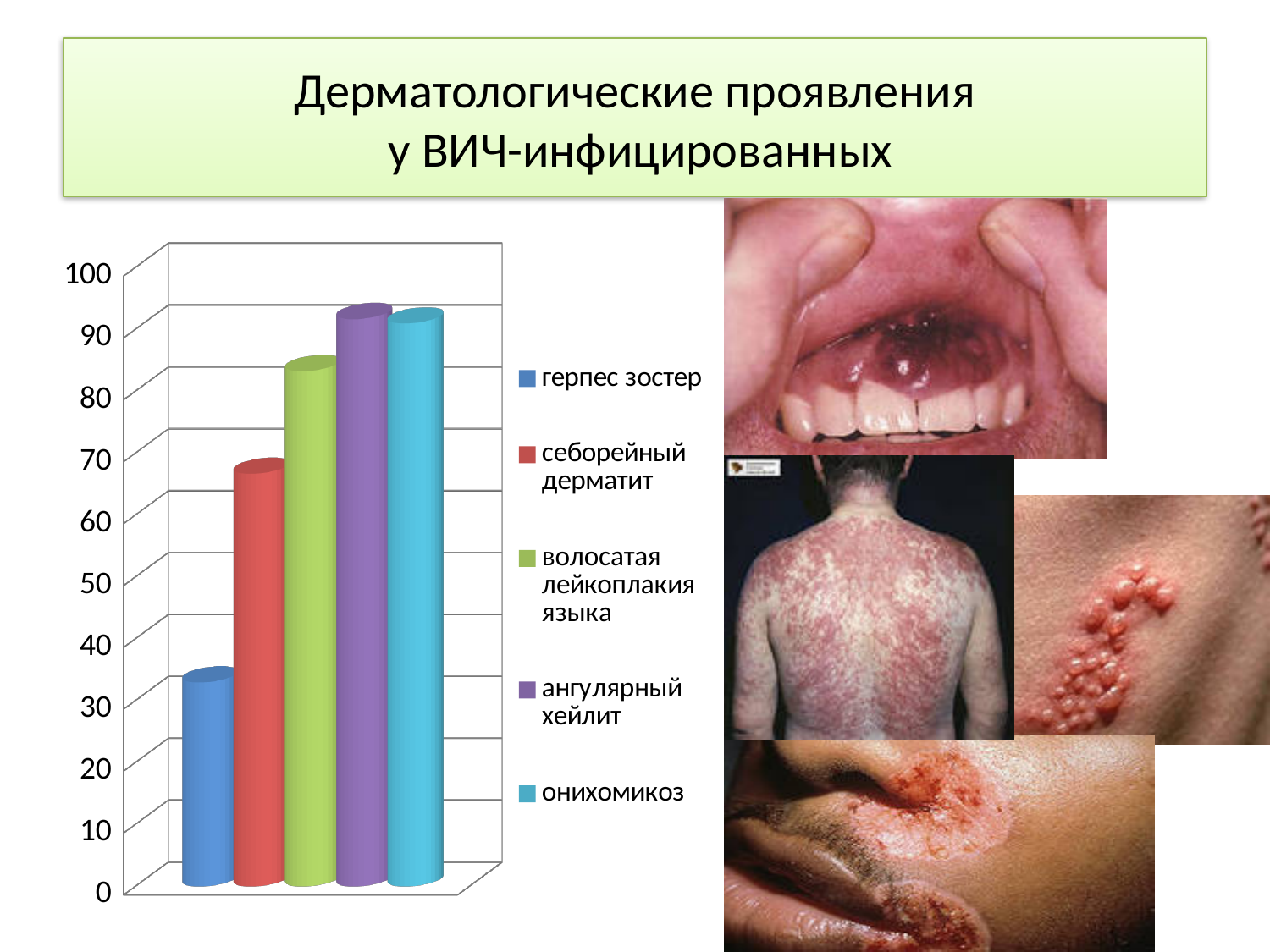
What kind of chart is shown on the slide? bar chart Is the value for себорейный дерматит greater or less than 70? less Is the value for ангулярный хейлит greater or less than 80? greater Is the value for волосатая лейкоплакия языка greater or less than 70? greater What colour is the bar for ангулярный хейлит in the chart? purple Which is larger, the value for себорейный дерматит or the value for волосатая лейкоплакия языка? волосатая лейкоплакия языка How many series does the chart legend list? 5 How many bars are plotted in the chart? 5 Which series has the lowest bar in the chart? герпес зостер